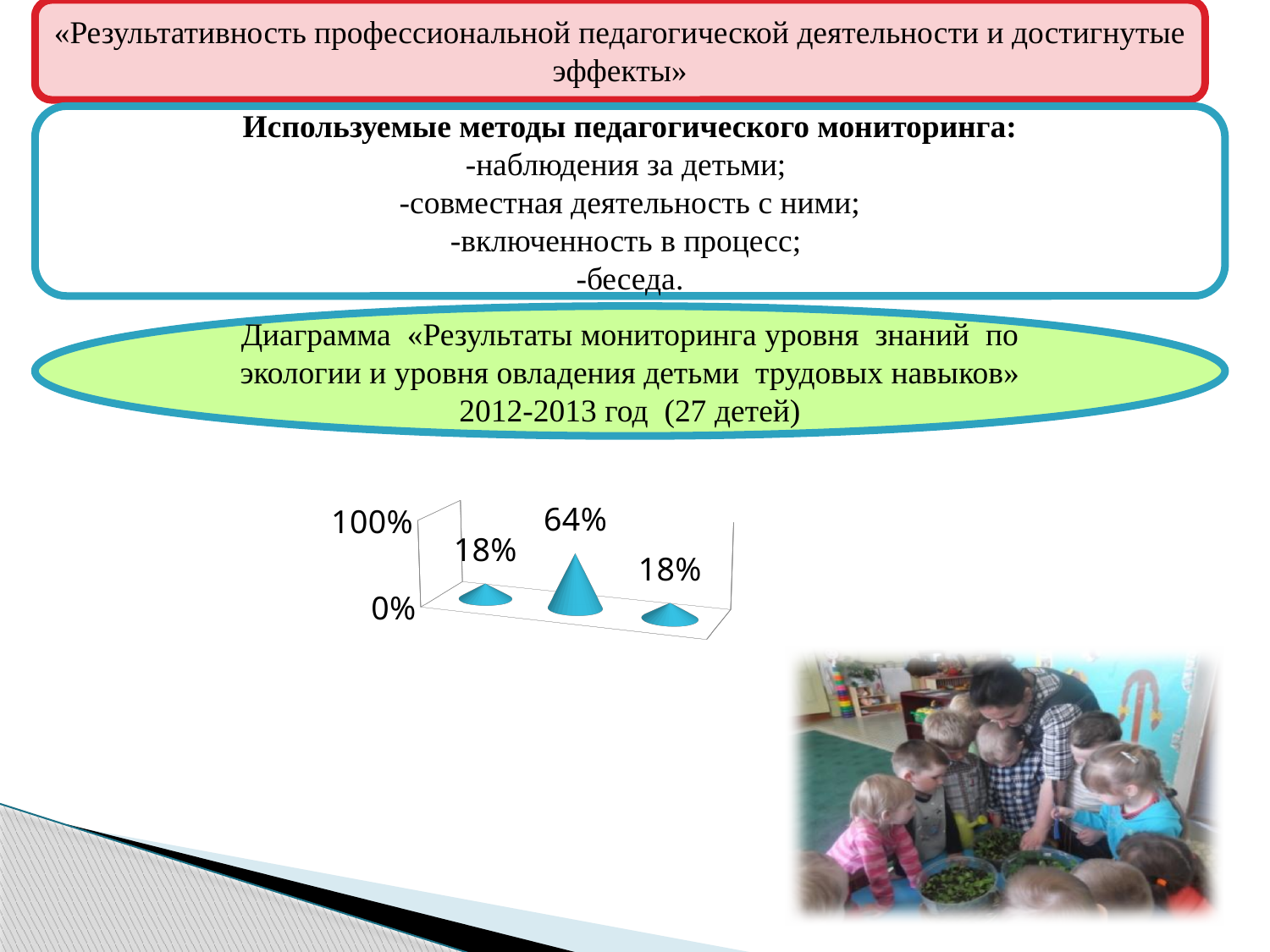
Which bar is larger: the middle bar or the leftmost bar? the middle bar According to the slide, how many children were covered by the monitoring shown in the chart? 27 What is the value shown on the middle bar of the chart? 64% What is the highest value shown in the chart? 64% What is the maximum value labelled on the chart's vertical axis? 100% How many bars are plotted in the chart? 3 What is the lowest value shown in the chart? 18% What kind of chart is shown on the slide? bar chart What is the difference between the highest value (64%) and the lowest value (18%) in the chart? 46% What is the value shown on the rightmost bar of the chart? 18% What is the value shown on the leftmost bar of the chart? 18%